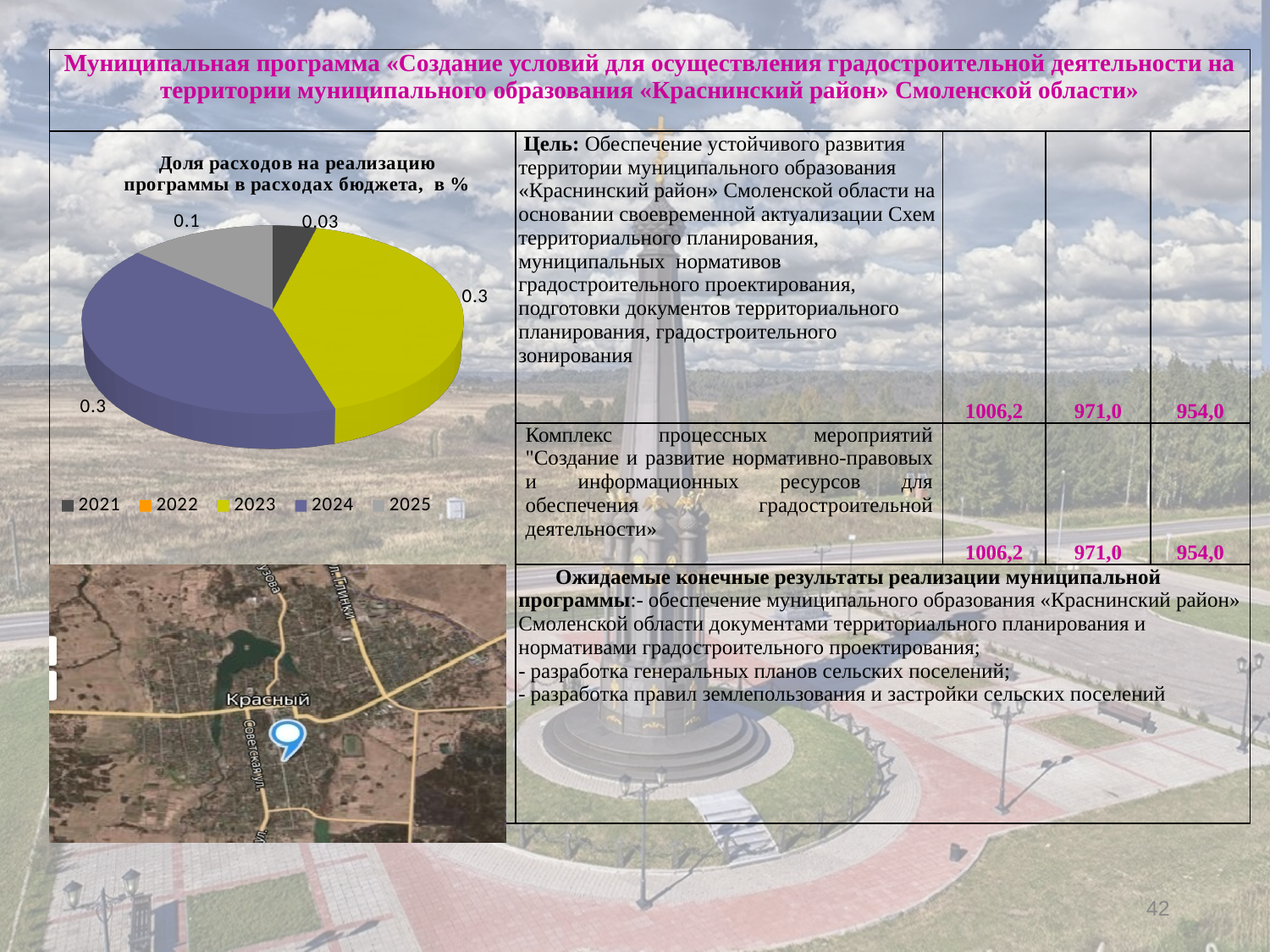
What is the difference between the values for 2023 and 2025 in the pie chart? 0.2 What value is shown for 2021 in the pie chart? 0.03 Which is larger in the pie chart, the value for 2021 or the value for 2025? 2025 What value is shown for 2025 in the pie chart? 0.1 How many entries does the legend of the pie chart list? 5 What is the title of the pie chart? Доля расходов на реализацию программы в расходах бюджета, в % What is the difference between the values for 2025 and 2021 in the pie chart? 0.07 What value is shown for 2023 in the pie chart? 0.3 What value is shown for 2024 in the pie chart? 0.3 What kind of chart is shown on the slide? pie chart Which year is shown in yellow in the pie chart? 2023 Which is larger in the pie chart, the value for 2023 or the value for 2025? 2023